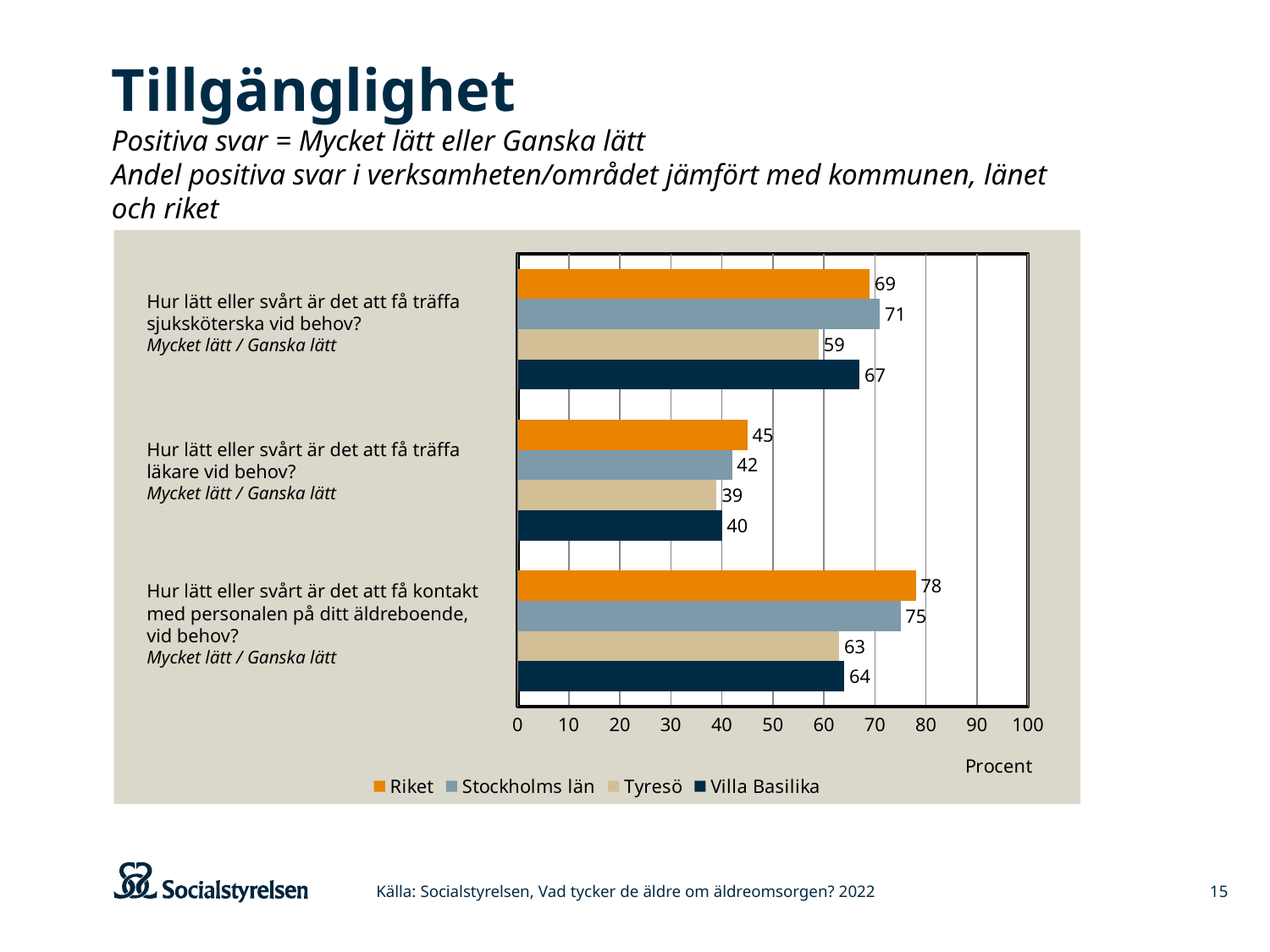
Which series has the highest value for the question about getting to meet a nurse (sjuksköterska) when needed? Stockholms län What is the value for Villa Basilika for the question about getting to meet a nurse (sjuksköterska) when needed? 67 What is the value for Riket for the question about getting in contact with staff at the äldreboende when needed? 78 What is the value for Tyresö for the question about getting to meet a doctor (läkare) when needed? 39 Which series has the lowest value for the question about getting in contact with staff at the äldreboende when needed? Tyresö What type of chart is shown on the slide? bar chart What is the difference between Riket and Tyresö for the question about getting in contact with staff at the äldreboende when needed? 15 How many question categories are plotted on the chart? 3 What unit is shown on the x axis of the chart? Procent Which is larger for the question about getting to meet a doctor (läkare) when needed: Riket or Stockholms län? Riket How many series does the legend list? 4 Is the value for Villa Basilika for the question about getting to meet a doctor (läkare) when needed greater or less than 50? less